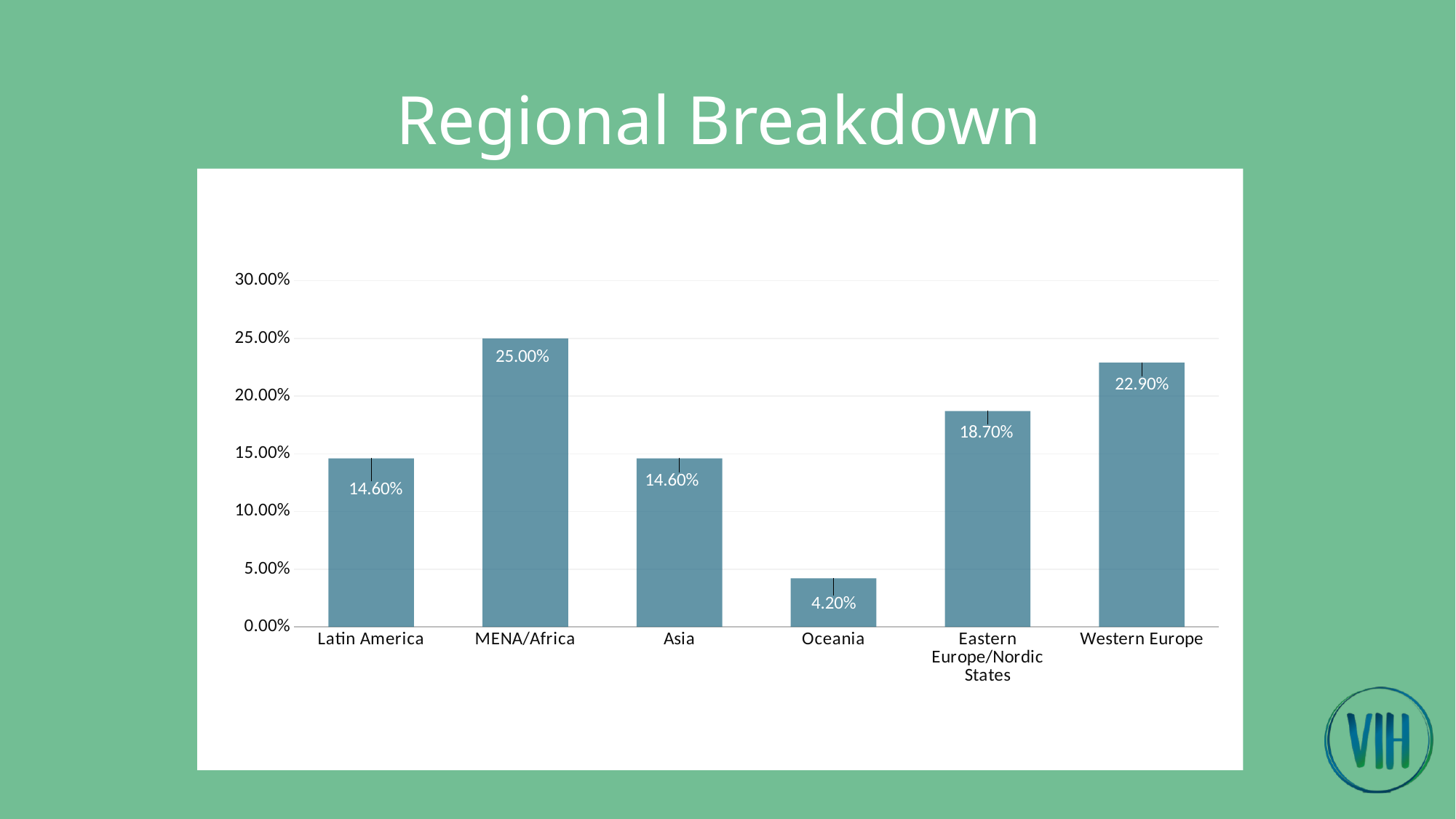
What is the value for Eastern Europe/Nordic States? 18.70% Is the value for Western Europe greater or less than 20.00%? greater How many regions are shown on the chart? 6 What is the value for Western Europe? 22.90% Which is larger, the value for Eastern Europe/Nordic States or the value for Latin America? Eastern Europe/Nordic States What is the difference between the values for MENA/Africa and Western Europe? 2.10% Which region has the highest value? MENA/Africa What kind of chart is shown on the slide? Bar chart What is the value for MENA/Africa? 25.00% What is the value for Oceania? 4.20% What is the title of the slide? Regional Breakdown Which region has the lowest value? Oceania